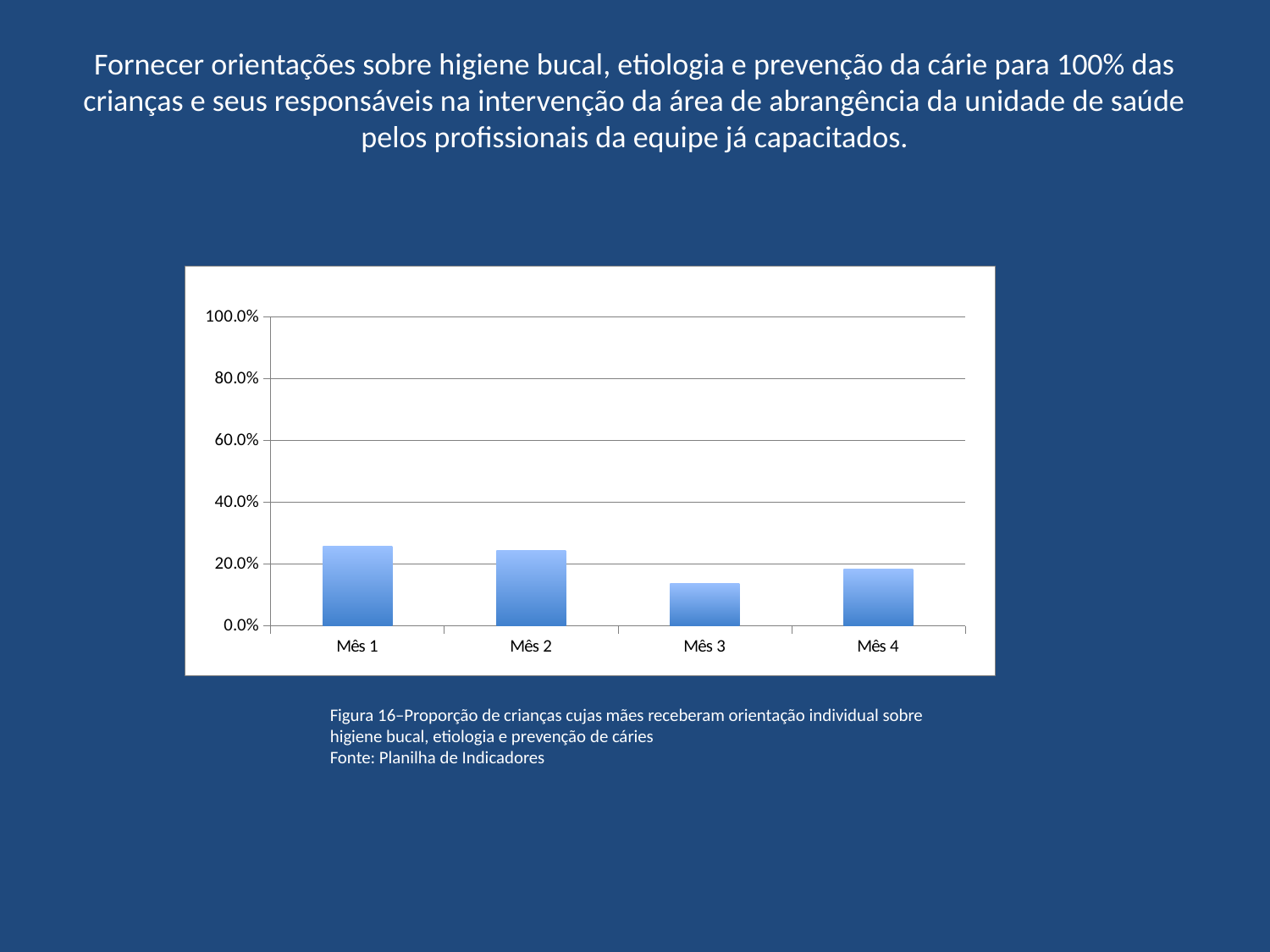
What is the highest value shown on the y axis of the chart? 100.0% According to the caption below the chart, what is the source of the data? Planilha de Indicadores Is the value for Mês 3 greater or less than 20.0%? less Is the value for Mês 1 greater or less than 20.0%? greater What kind of chart is shown on the slide? bar chart Which month has the lowest bar in the chart? Mês 3 Is the value for Mês 2 greater or less than 40.0%? less Which is larger, the value for Mês 4 or the value for Mês 3? Mês 4 Which is larger, the value for Mês 1 or the value for Mês 3? Mês 1 How many months (categories) are plotted on the x axis of the chart? 4 Do the values in the chart rise or fall from Mês 2 to Mês 3? fall